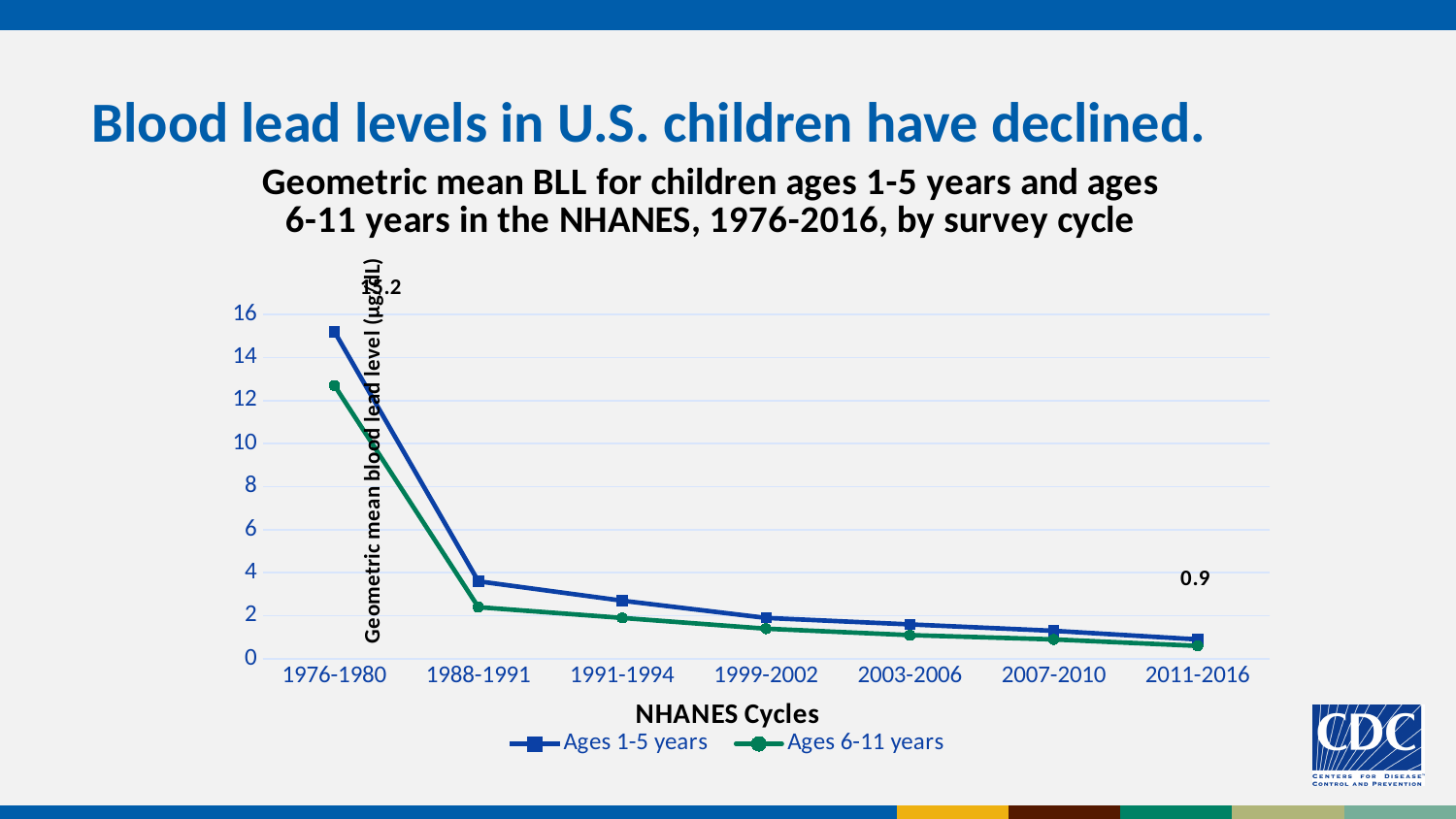
How many NHANES cycles are shown on the x axis? 7 Is the value for Ages 1-5 years in 1976-1980 greater or less than 14? greater What is the title of the x axis? NHANES Cycles For Ages 6-11 years, which survey cycle has the lowest value? 2011-2016 How many series does the legend list? 2 In the 1976-1980 cycle, which series has the higher value, Ages 1-5 years or Ages 6-11 years? Ages 1-5 years Is the value for Ages 1-5 years in 1988-1991 greater or less than 4? less For Ages 1-5 years, which survey cycle has the highest value? 1976-1980 Do the blood lead levels rise or fall across the survey cycles from 1976-1980 to 2011-2016? Fall Is the value for Ages 6-11 years in 1976-1980 greater or less than 10? greater What kind of chart is shown on the slide? Line chart What is the geometric mean BLL for Ages 1-5 years in the 2011-2016 cycle? 0.9